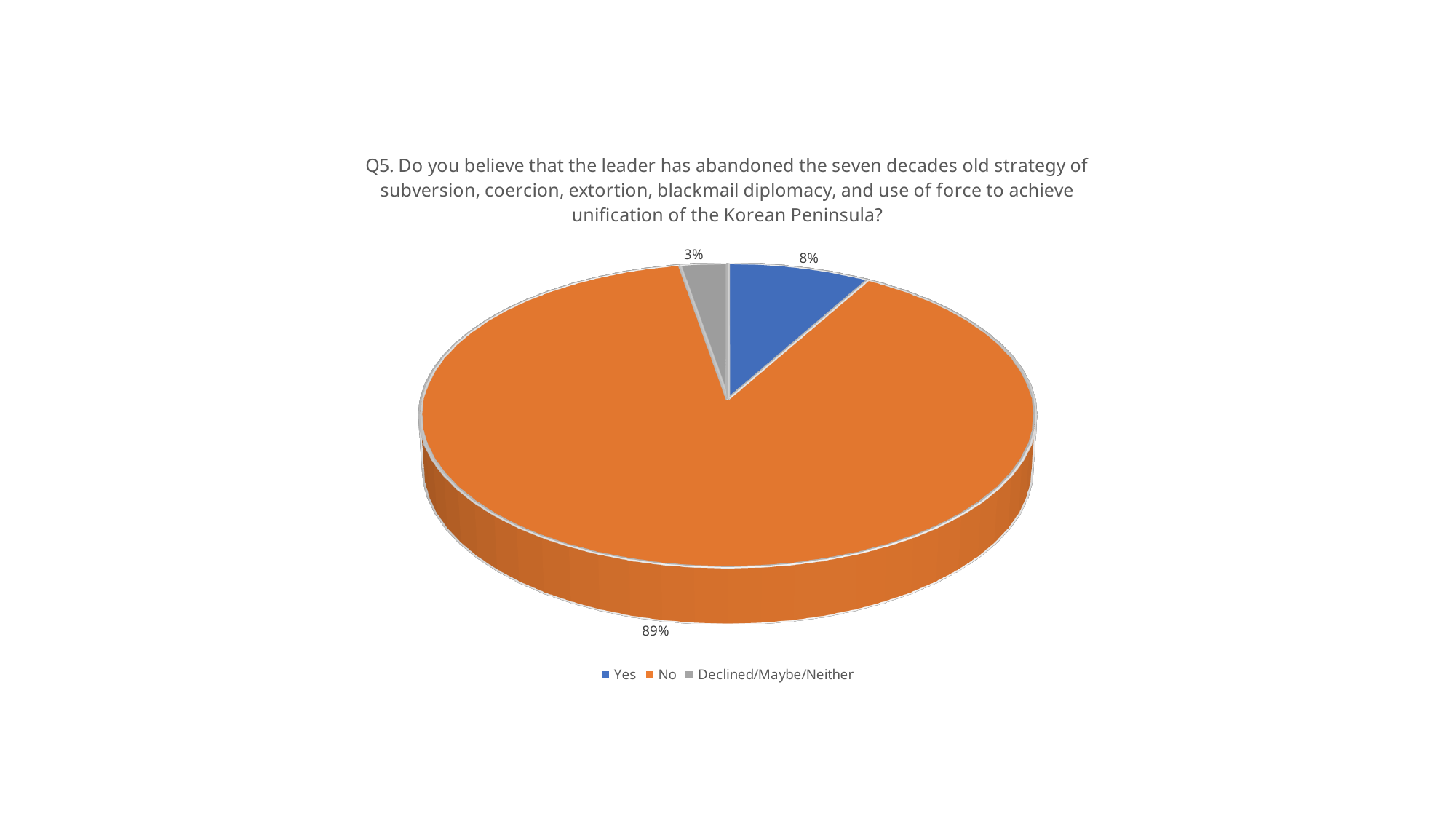
Which is larger, the "Yes" share or the "Declined/Maybe/Neither" share? Yes What kind of chart is shown on the slide? Pie chart How many categories does the pie chart have? 3 Which legend entry is shown in blue? Yes Which response has the largest share of the pie? No What colour is the "No" slice of the pie? Orange What percentage of respondents are in the "Declined/Maybe/Neither" category? 3% What is the difference in percentage points between the "No" and "Yes" shares? 81 Which response has the smallest share of the pie? Declined/Maybe/Neither What percentage of respondents answered "No"? 89% What is the difference in percentage points between the "Yes" and "Declined/Maybe/Neither" shares? 5 What percentage of respondents answered "Yes"? 8%